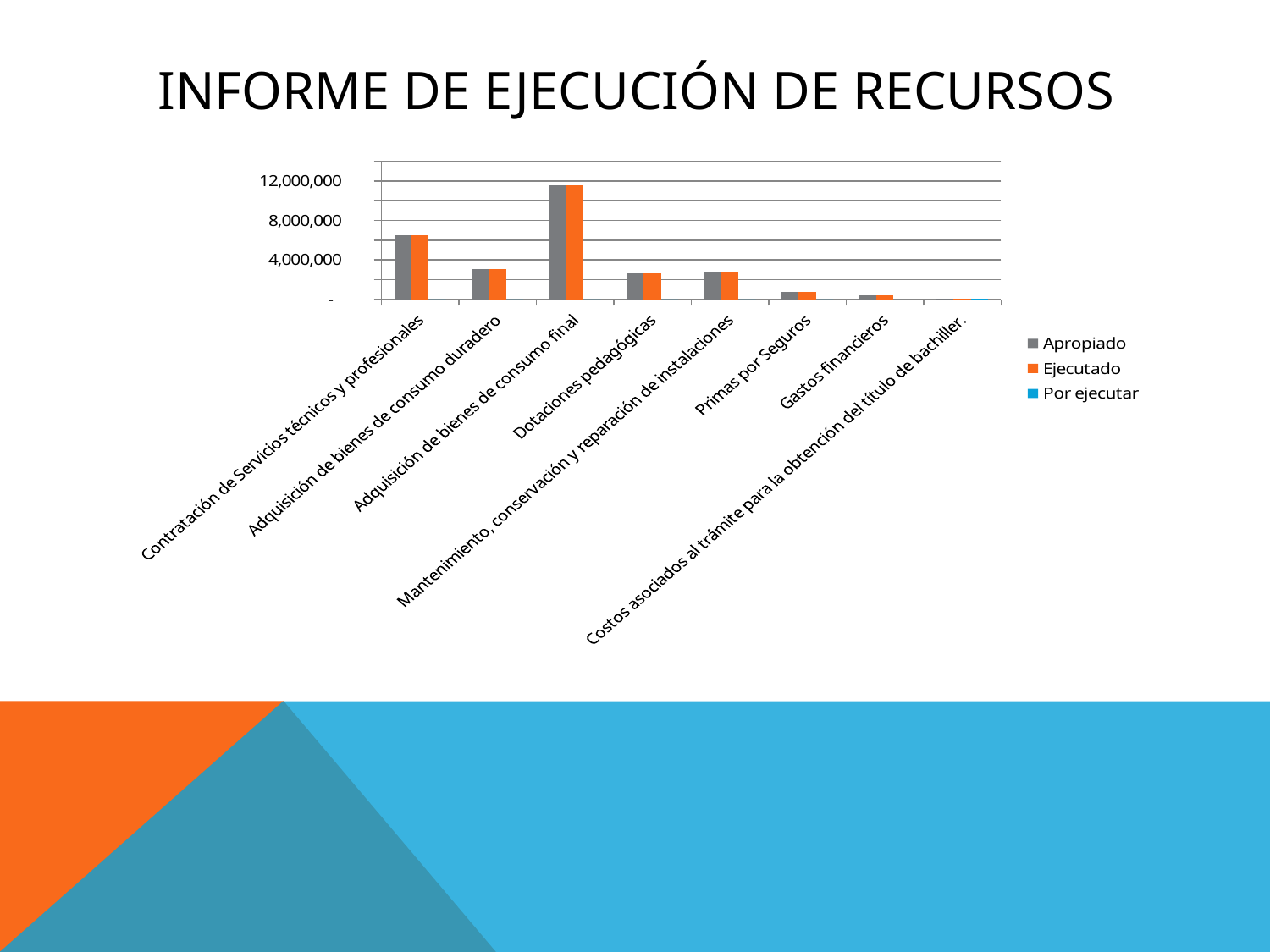
What is the title of the slide containing the chart? INFORME DE EJECUCIÓN DE RECURSOS Which category has the lowest Ejecutado value? Costos asociados al trámite para la obtención del título de bachiller. How many series does the legend list? 3 Which category has the highest Apropiado value? Adquisición de bienes de consumo final What kind of chart is shown on the slide? bar chart Is the Ejecutado value for Contratación de Servicios técnicos y profesionales greater or less than 4,000,000? greater Is the Ejecutado value for Primas por Seguros greater or less than 4,000,000? less Which has a larger Ejecutado value: Primas por Seguros or Gastos financieros? Primas por Seguros Which has a larger Apropiado value: Contratación de Servicios técnicos y profesionales or Adquisición de bienes de consumo duradero? Contratación de Servicios técnicos y profesionales Is the Apropiado value for Dotaciones pedagógicas greater or less than 4,000,000? less How many categories are shown on the x axis of the chart? 8